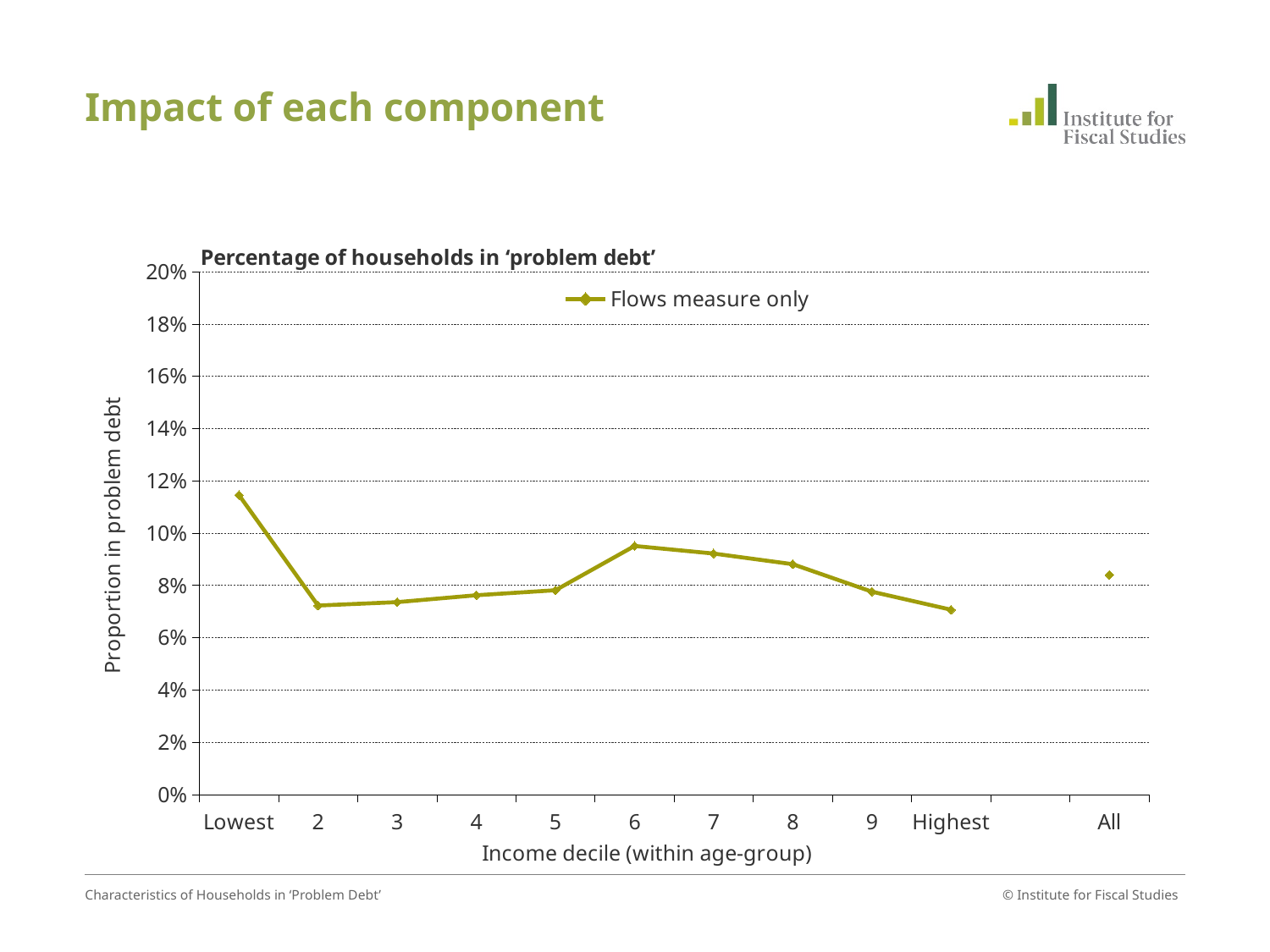
Which income decile has the highest proportion in problem debt? Lowest Is the value for income decile 2 greater or less than 8%? less Is the value for income decile 6 greater or less than 10%? less What is the title of the chart? Percentage of households in ‘problem debt’ Which has a higher proportion in problem debt, the Lowest decile or decile 6? Lowest How many series does the legend list? 1 How many categories are shown on the x axis? 11 Is the value for the Highest income decile greater or less than 8%? less What is the name of the series shown in the legend? Flows measure only What kind of chart is shown on the slide? Line chart Do the values rise or fall from income decile 6 to the Highest decile? fall